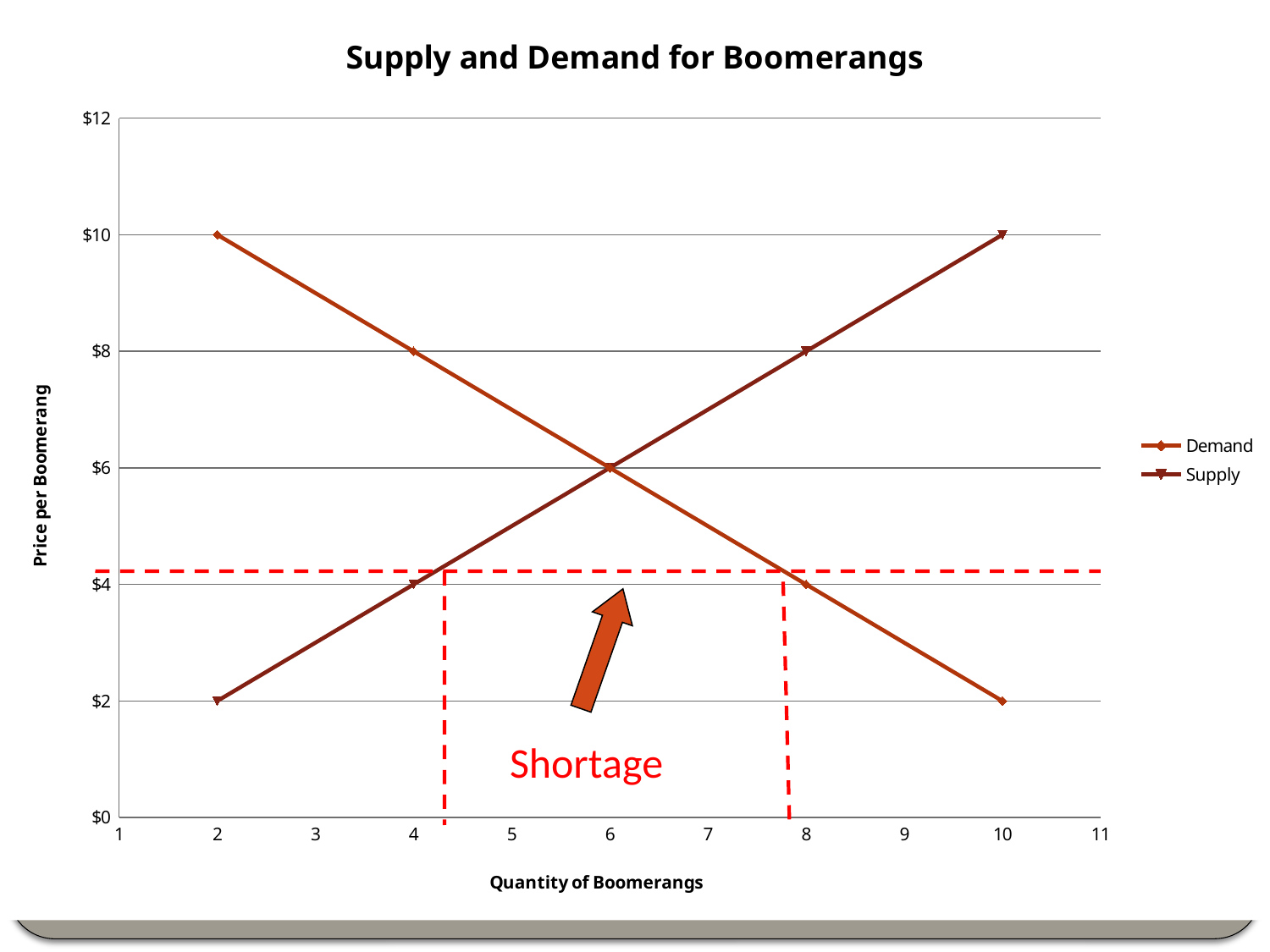
At what price do the Demand and Supply lines cross? $6 What kind of chart is shown on the slide? line chart At what quantity do the Demand and Supply lines cross? 6 How many series does the legend list? 2 What is the price on the Demand line at a quantity of 2 boomerangs? $10 Does the Demand line rise or fall as quantity increases? fall What is the difference between the Demand price and the Supply price at a quantity of 10? $8 What is the title of the chart? Supply and Demand for Boomerangs How many data points are plotted on the Demand line? 5 What is the price on the Supply line at a quantity of 2 boomerangs? $2 Does the Supply line rise or fall as quantity increases? rise At a quantity of 4, which is higher, the Demand price or the Supply price? Demand